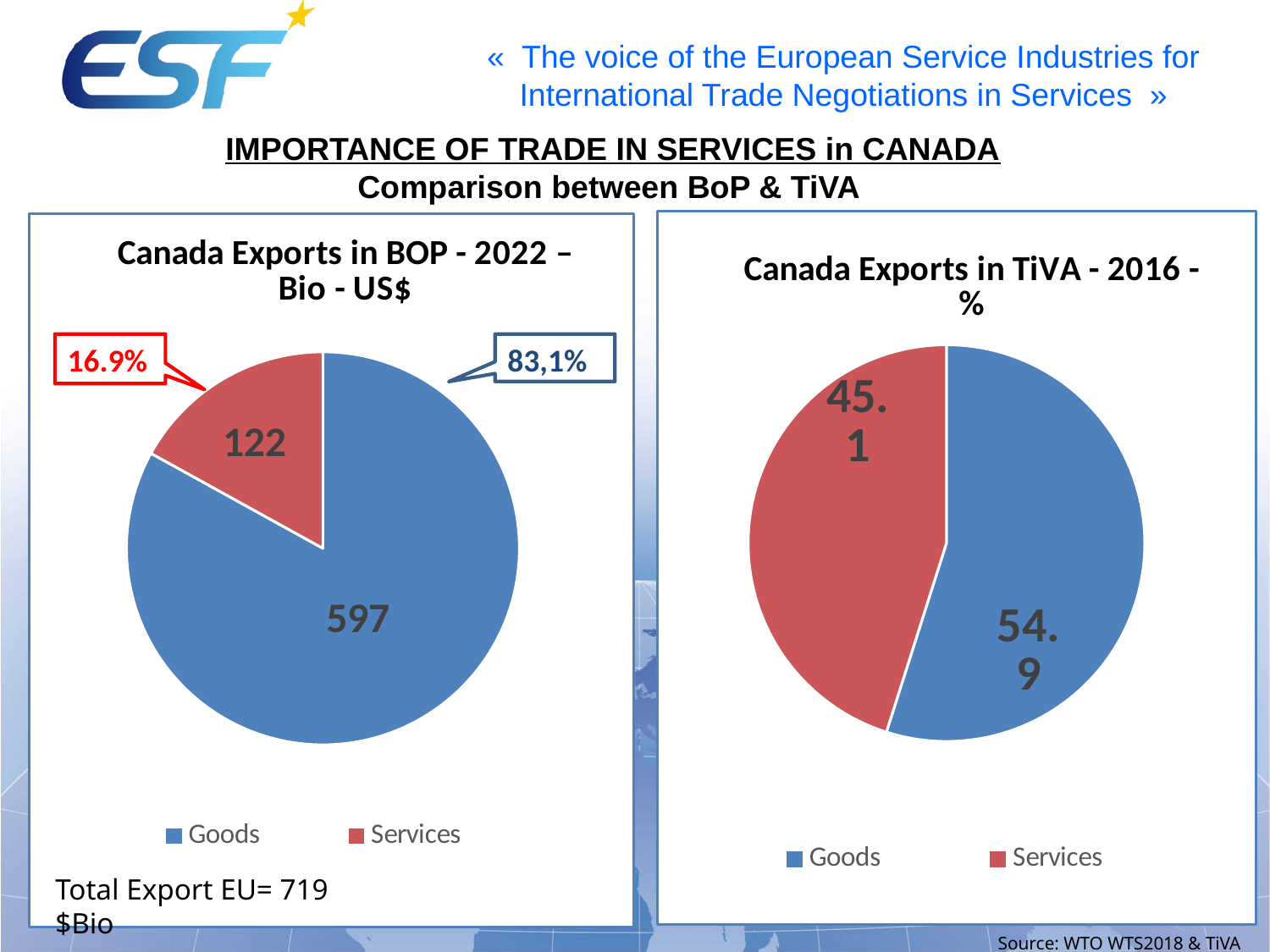
How many categories does the legend of the 'Canada Exports in TiVA - 2016' chart list? 2 In the 'Canada Exports in TiVA - 2016' chart, what is the value for Goods? 54.9 In the 'Canada Exports in BOP - 2022' chart, what share of the pie does the Goods slice represent according to the callout label? 83,1% In the 'Canada Exports in TiVA - 2016' chart, which is larger, Goods or Services? Goods In the 'Canada Exports in BOP - 2022' chart, what colour is the Services slice? red In the 'Canada Exports in BOP - 2022' chart, what is the value for Goods? 597 In the 'Canada Exports in BOP - 2022' chart, what share of the pie does the Services slice represent according to the callout label? 16.9% In the 'Canada Exports in TiVA - 2016' chart, what is the value for Services? 45.1 In the 'Canada Exports in BOP - 2022' chart, what is the value for Services? 122 What kind of chart is the 'Canada Exports in BOP - 2022' chart? pie chart In the 'Canada Exports in BOP - 2022' chart, what is the difference between the Goods and Services values? 475 In the 'Canada Exports in BOP - 2022' chart, which category has the largest slice? Goods